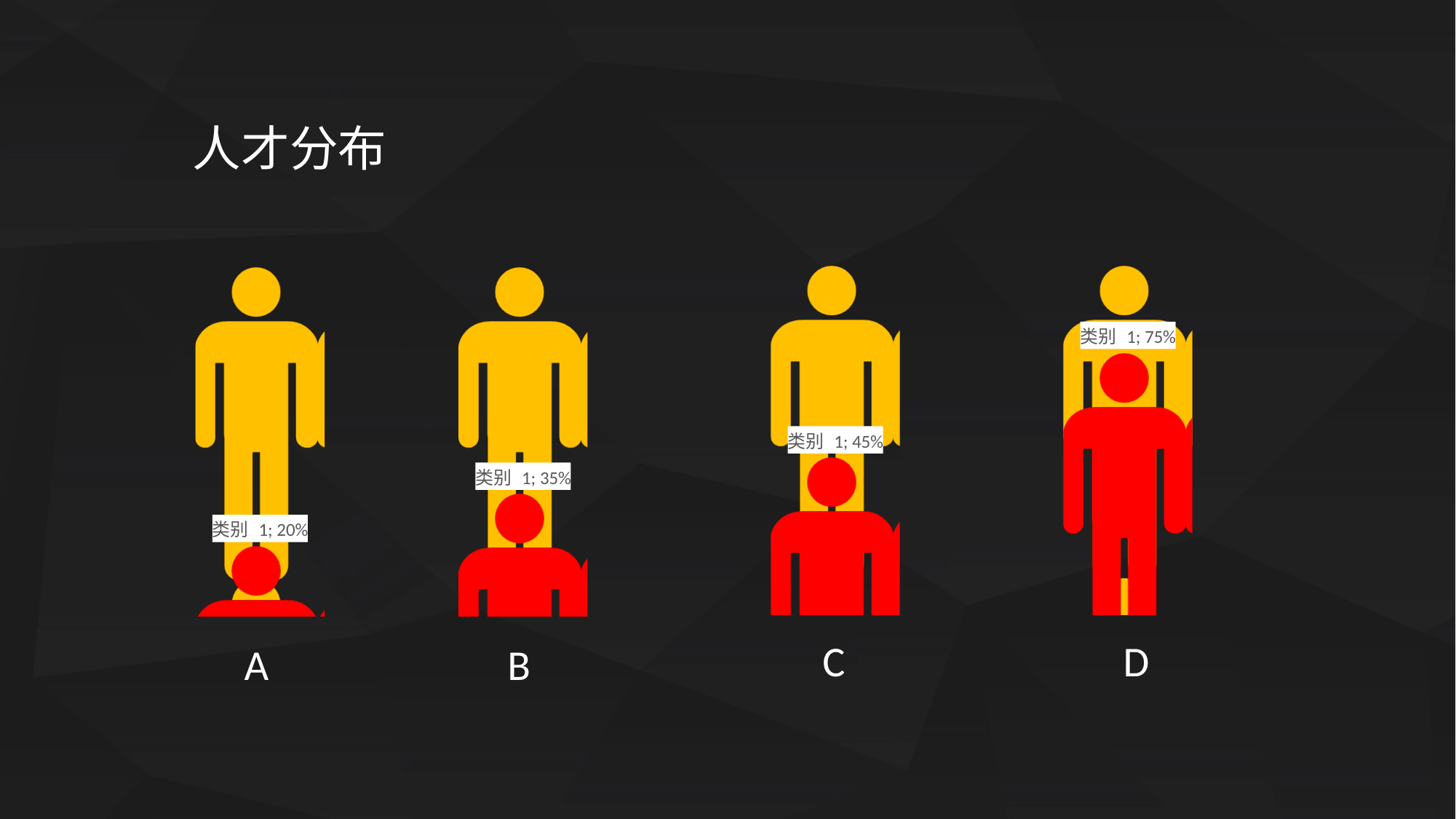
What is the value shown for category A? 20% What is the value shown for category D? 75% What is the value shown for category B? 35% What is the difference between the values for D and A? 55% What is the title of the chart? 人才分布 Which category has the lowest value? A What is the difference between the values for C and B? 10% What is the value shown for category C? 45% How many categories are shown in the chart? 4 Which category has the highest value? D Which is larger, the value for B or the value for C? C Do the values rise or fall from A to D? rise